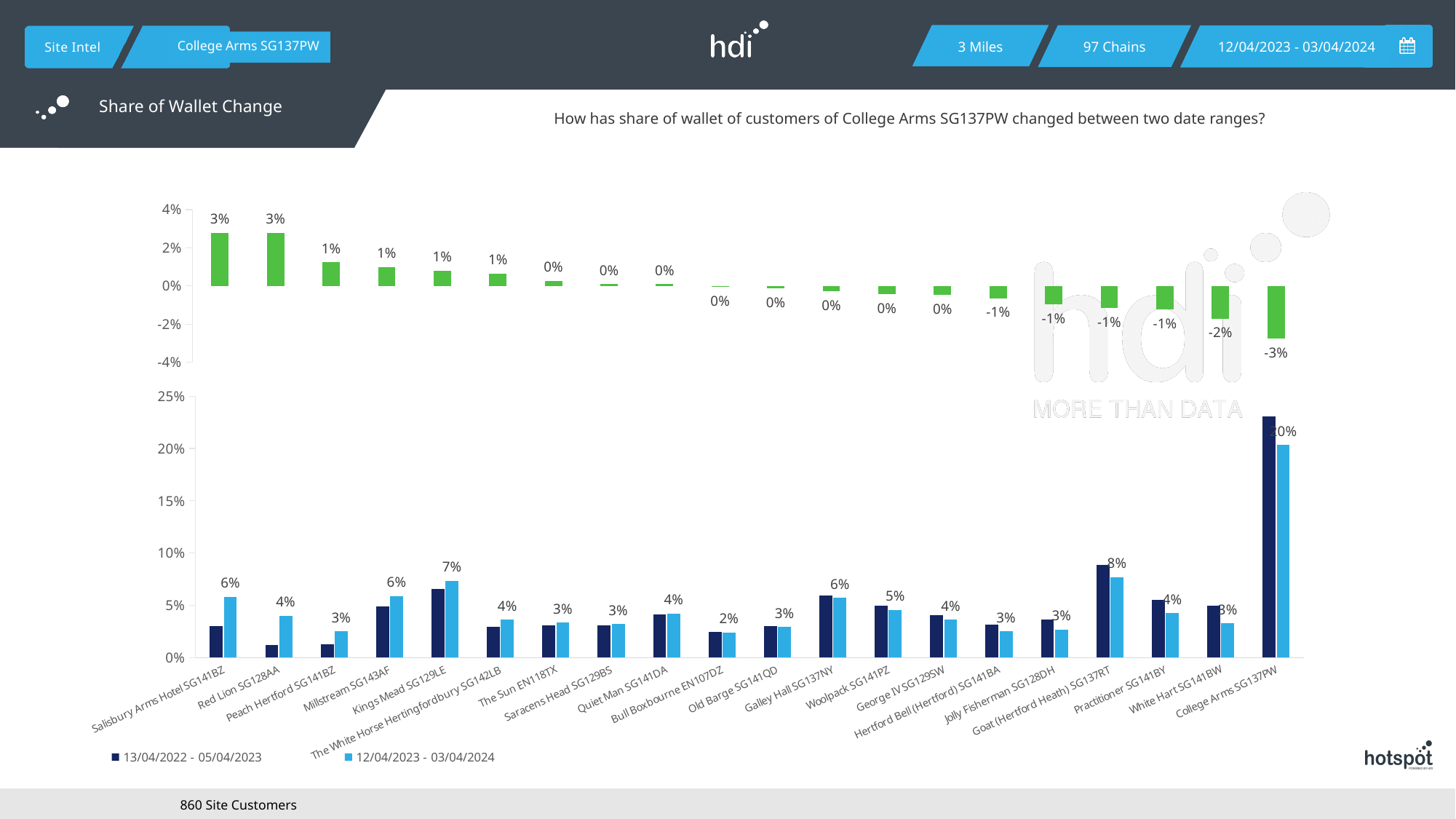
In the upper (share of wallet change) chart, which site has the lowest value? College Arms SG137PW What kind of chart is the lower chart on the slide? bar chart In the upper (share of wallet change) chart, what is the value for Goat (Hertford Heath) SG137RT? -1% In the lower chart, which site has the highest labelled value for the 12/04/2023 - 03/04/2024 period? College Arms SG137PW In the upper (share of wallet change) chart, what is the value for White Hart SG141BW? -2% How many series does the legend of the lower chart list? 2 In the lower chart, for Salisbury Arms Hotel SG141BZ, which period has the larger bar: 13/04/2022 - 05/04/2023 or 12/04/2023 - 03/04/2024? 12/04/2023 - 03/04/2024 How many sites are shown along the x axis of the lower chart? 20 Which two date ranges are listed in the legend of the lower chart? 13/04/2022 - 05/04/2023 and 12/04/2023 - 03/04/2024 In the lower chart, is the 13/04/2022 - 05/04/2023 value for College Arms SG137PW greater or less than 20%? greater In the lower chart, what is the labelled value for Kings Mead SG129LE in the 12/04/2023 - 03/04/2024 period? 7% In the upper (share of wallet change) chart, what is the difference between the values for Salisbury Arms Hotel SG141BZ and College Arms SG137PW? 6%